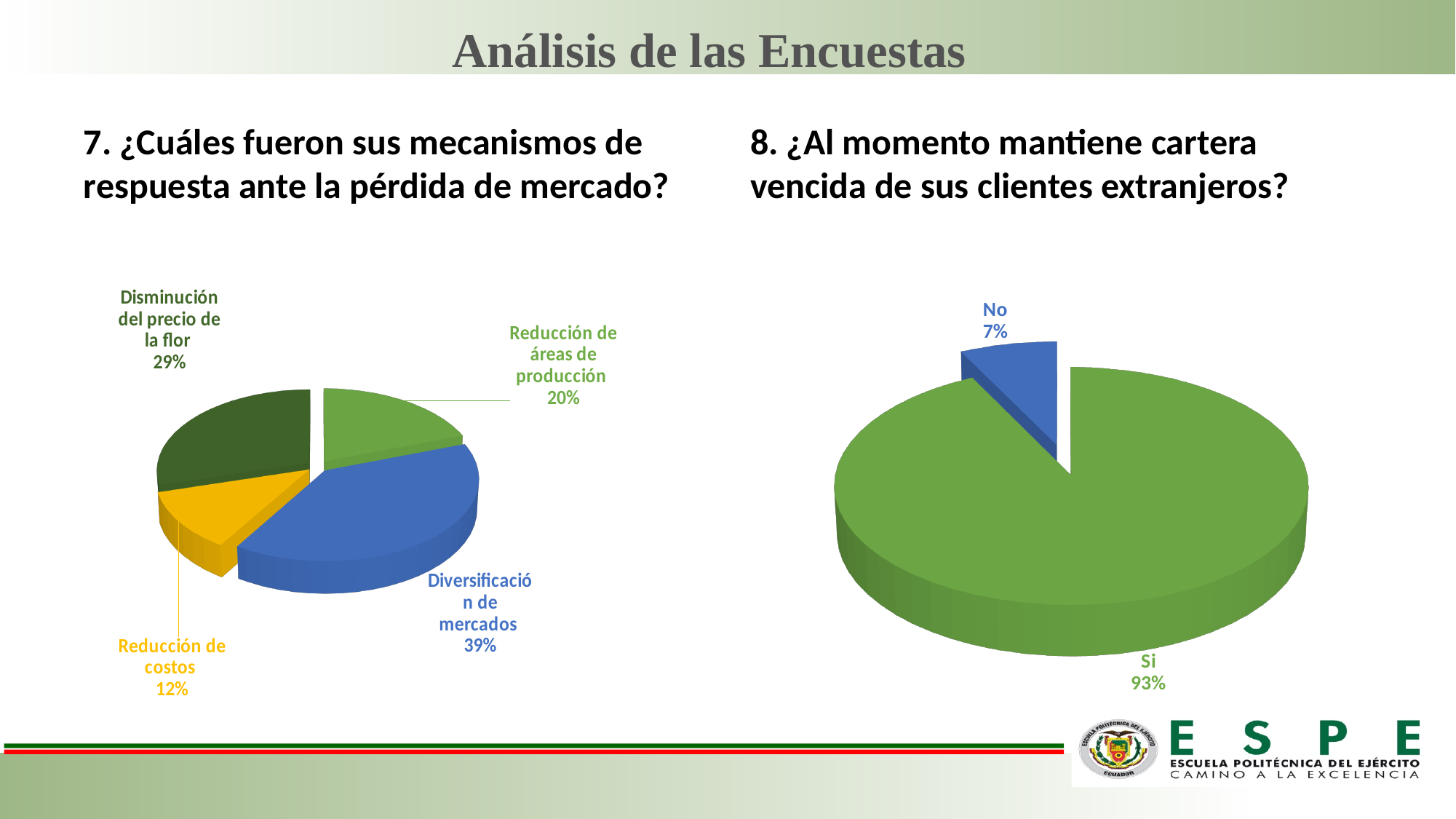
In the left pie chart (question 7), what share is labelled for Diversificación de mercados? 39% In the left pie chart (question 7), how many slices are there? 4 What type of chart is used for question 8 on the right? Pie chart In the left pie chart (question 7), what is the difference between the shares for Diversificación de mercados and Reducción de áreas de producción? 19% In the left pie chart (question 7), which category has the smallest share? Reducción de costos In the left pie chart (question 7), which category has the largest share? Diversificación de mercados In the right pie chart (question 8), what share is labelled for No? 7% In the left pie chart (question 7), what share is labelled for Disminución del precio de la flor? 29% In the left pie chart (question 7), what share is labelled for Reducción de costos? 12% In the right pie chart (question 8), what share is labelled for Si? 93% In the right pie chart (question 8), what colour is the Si slice? Green In the left pie chart (question 7), which is larger: Disminución del precio de la flor or Reducción de áreas de producción? Disminución del precio de la flor